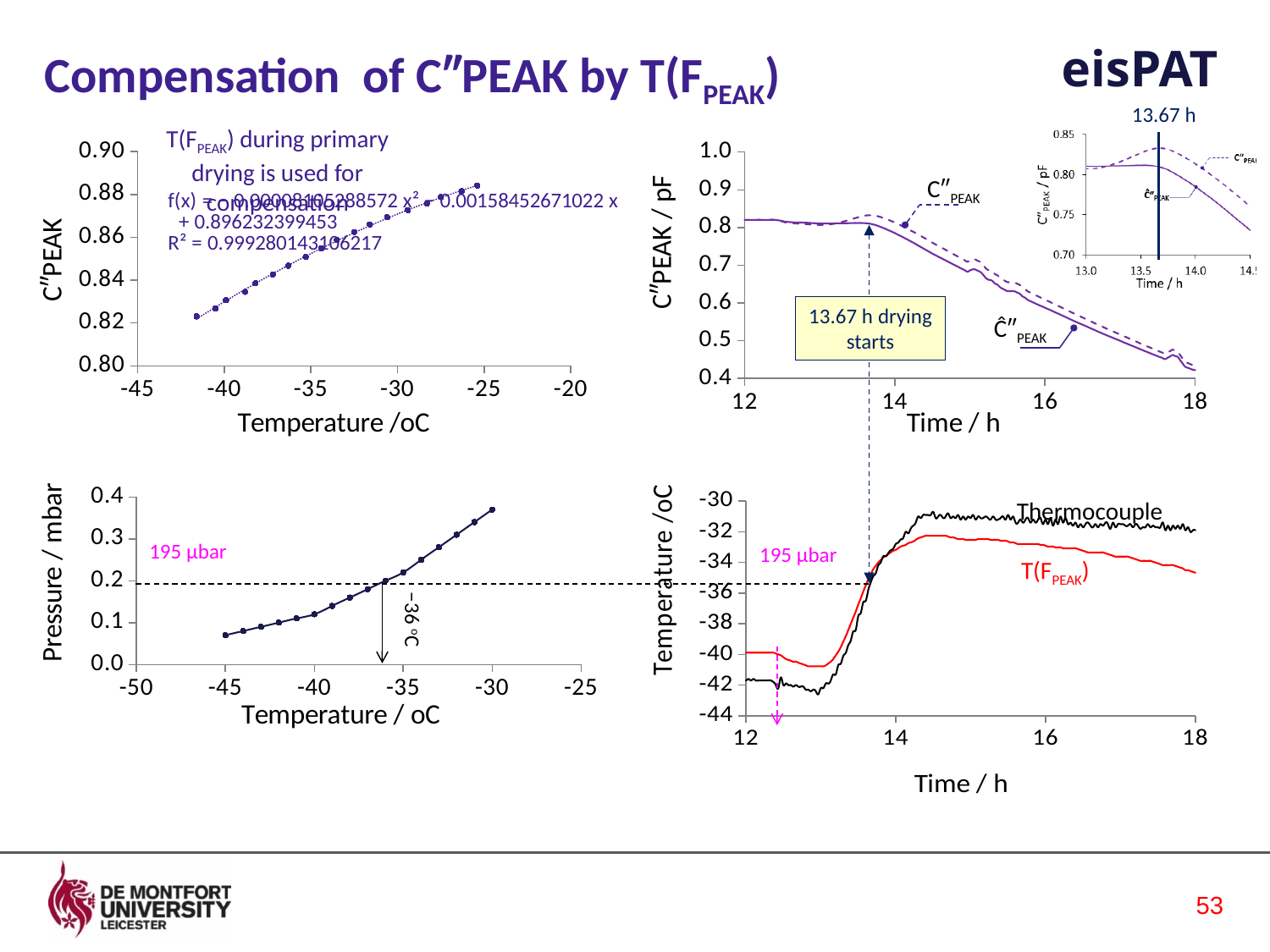
In the bottom-left chart of Pressure against Temperature, what temperature is marked by the vertical arrow where the curve crosses the dashed line? -36 °C In the top-left chart of C″PEAK against Temperature, what R² value is printed for the fitted trend line? 0.999280143106217 In the top-left chart of C″PEAK against Temperature, is the value at -35 °C greater or less than 0.84? greater In the bottom-right chart of Temperature against Time, is the Thermocouple value at 12 h greater or less than -40 °C? less In the top-right chart of C″PEAK / pF against Time, is the value of C″PEAK at 18 h greater or less than 0.5? less In the top-right chart of C″PEAK / pF against Time, how many series are plotted? 2 In the top-right chart of C″PEAK / pF against Time, at what time does the annotation say drying starts? 13.67 h In the bottom-left chart of Pressure against Temperature, what pressure is marked by the horizontal dashed line? 195 µbar In the bottom-right chart of Temperature against Time, what are the two labelled series? Thermocouple and T(FPEAK) In the top-left chart of C″PEAK against Temperature, do the plotted values rise or fall as temperature increases from -45 to -20 °C? rise